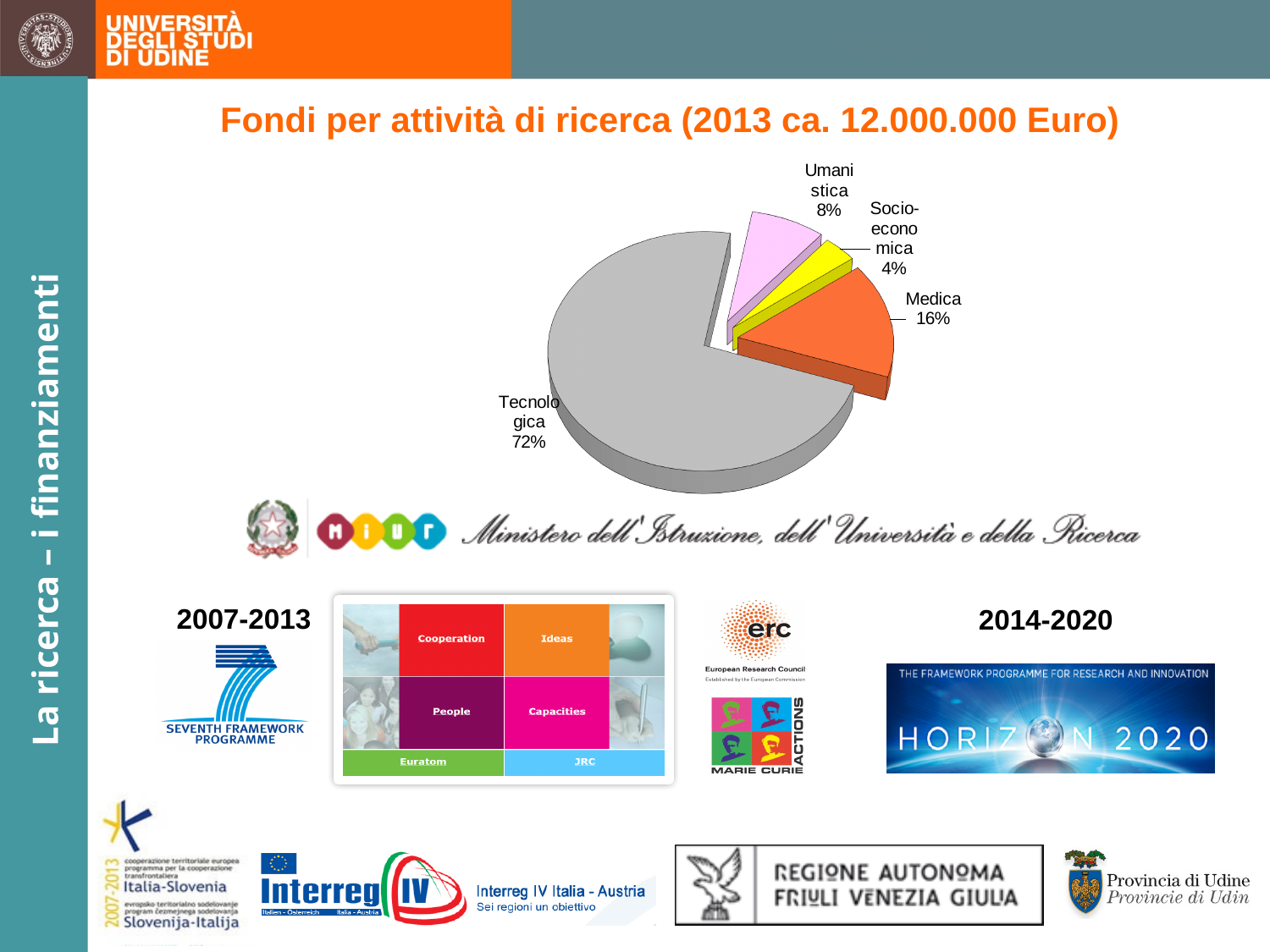
What share of the pie does Medica have? 16% What share of the pie does Tecnologica have? 72% What share of the pie does Umanistica have? 8% Which category has the smallest slice of the pie? Socio-economica What share of the pie does Socio-economica have? 4% What is the combined share of Medica and Umanistica? 24% Which is larger, the Umanistica slice or the Socio-economica slice? Umanistica How many slices does the pie chart have? 4 What is the difference in percentage points between Tecnologica and Medica? 56 What is the title of the chart? Fondi per attività di ricerca (2013 ca. 12.000.000 Euro) What kind of chart is shown on the slide? pie chart Which category has the largest slice of the pie? Tecnologica